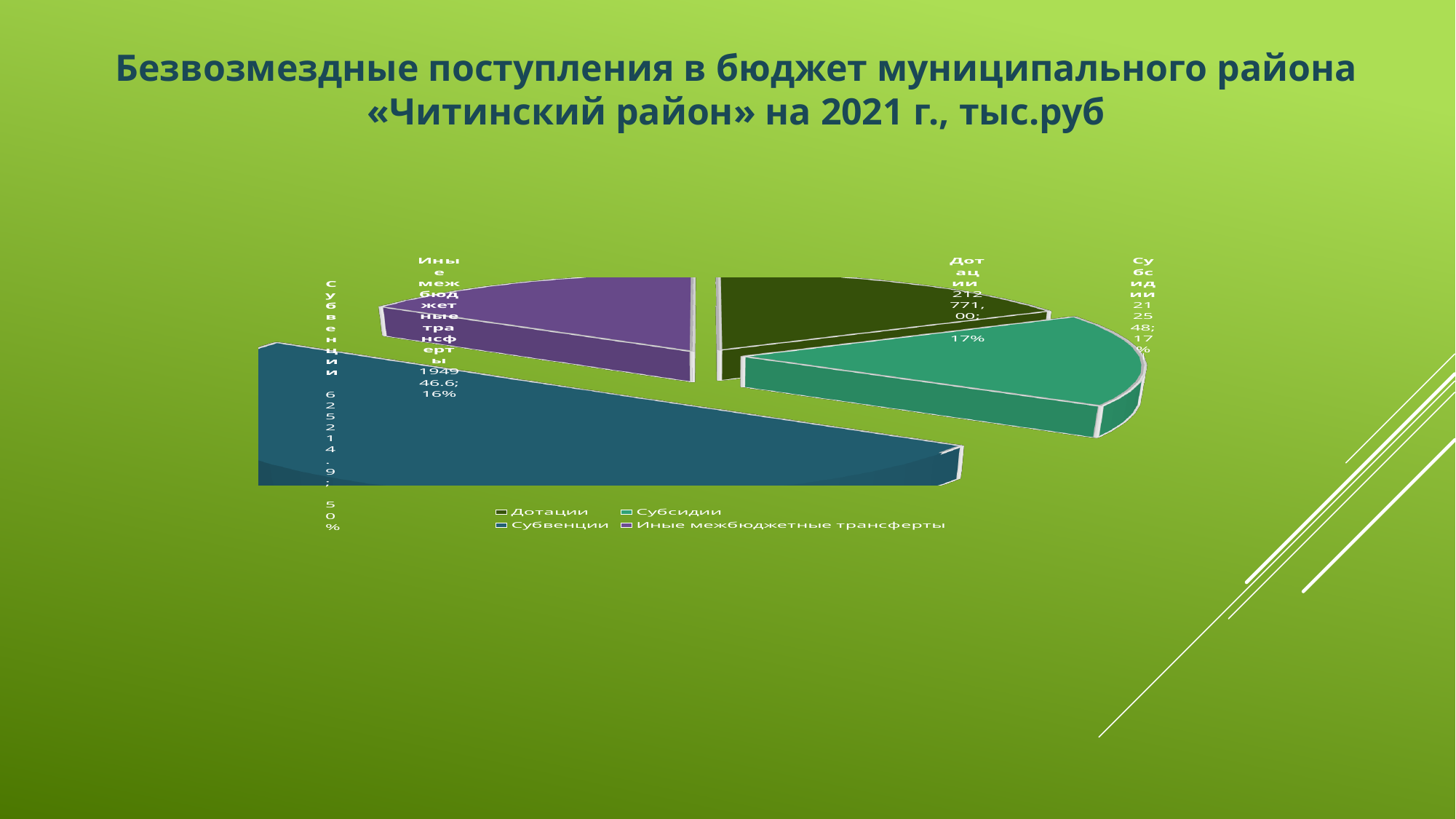
By how many percentage points does the share of Субвенции exceed the share of Иные межбюджетные трансферты? 34 What share of the pie does Дотации account for? 17% Which category has the largest slice of the pie? Субвенции What share of the pie does Иные межбюджетные трансферты account for? 16% What kind of chart is shown on the slide? pie chart What share of the pie does Субвенции account for? 50% How many entries does the legend list? 4 What is the value shown for Субвенции? 625214.9 Which is larger, the slice for Субвенции or the slice for Дотации? Субвенции What is the value shown for Иные межбюджетные трансферты? 194946.6 Which category has the smallest slice of the pie? Иные межбюджетные трансферты How many slices does the pie chart have? 4